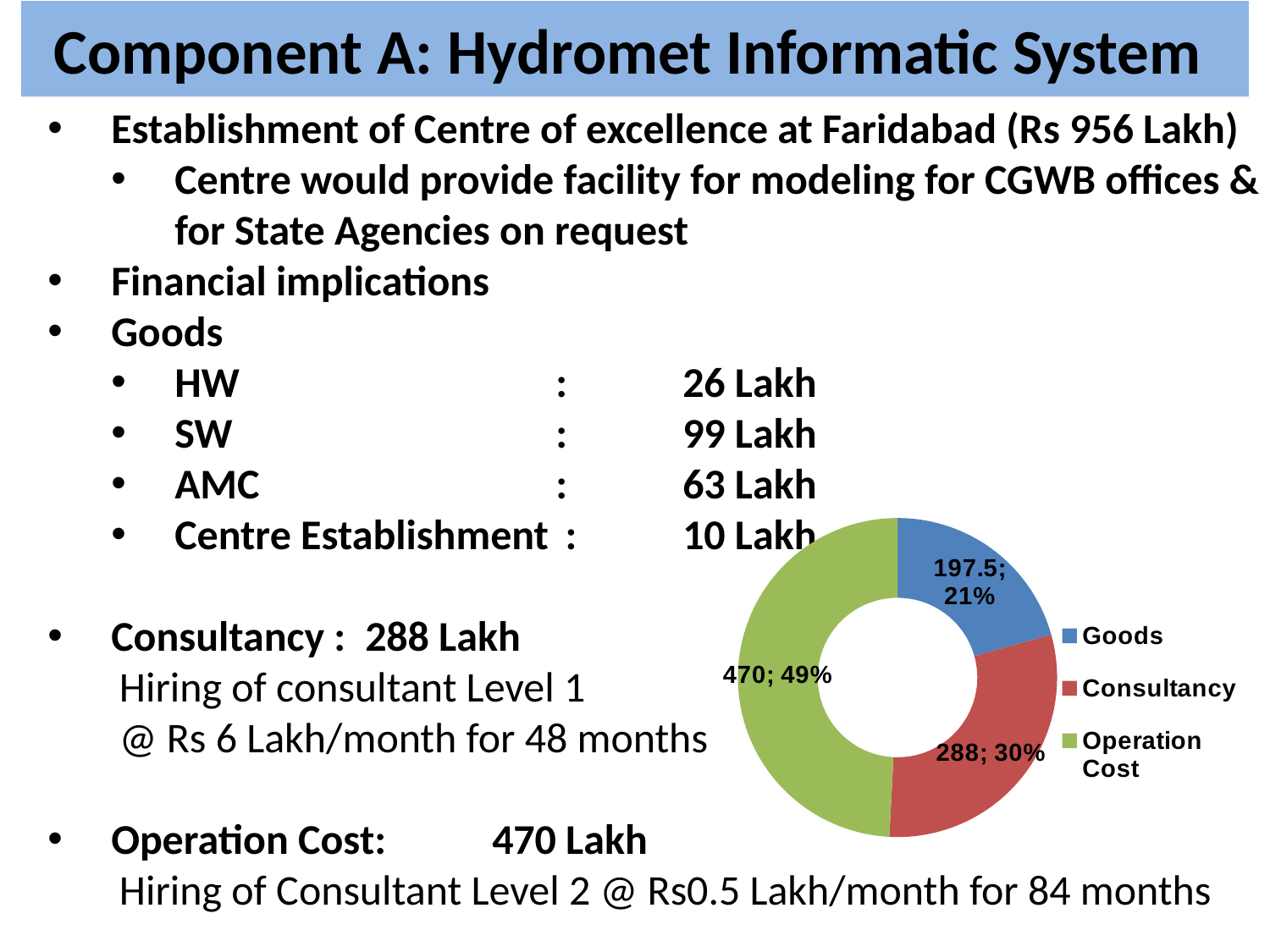
What value is shown for the Operation Cost slice in the chart? 470 Which is larger in the chart, Consultancy or Goods? Consultancy What percentage share does Goods have in the chart? 21% What kind of chart is shown on the slide? doughnut chart Which category has the smallest slice in the chart? Goods What percentage share does Operation Cost have in the chart? 49% What value is shown for the Goods slice in the chart? 197.5 What is the difference between the Operation Cost value and the Consultancy value in the chart? 182 How many categories does the chart's legend list? 3 What value is shown for the Consultancy slice in the chart? 288 What percentage share does Consultancy have in the chart? 30% Which category has the largest slice in the chart? Operation Cost